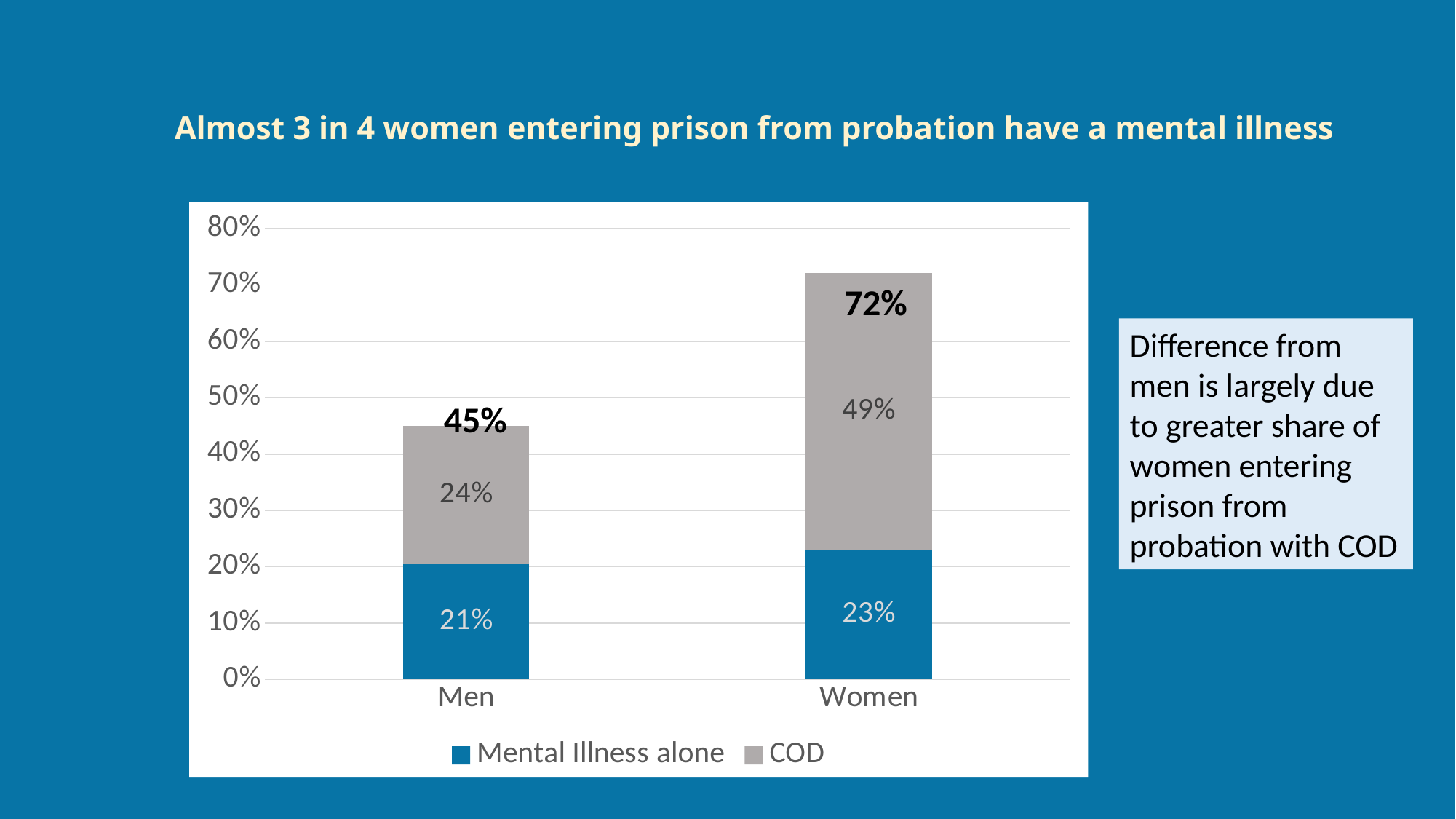
What is the value for Mental Illness alone for Women? 23% What kind of chart is shown on the slide? Stacked bar chart What is the total of the stacked bar for Men? 45% What is the total of the stacked bar for Women? 72% What is the value for COD for Men? 24% How many series does the legend list? 2 How many categories are shown on the x axis? 2 What is the value for Mental Illness alone for Men? 21% What is the difference between the total for Women and the total for Men? 27% What is the difference between the COD values for Women and Men? 25% Which category has the higher total, Men or Women? Women What is the value for COD for Women? 49%